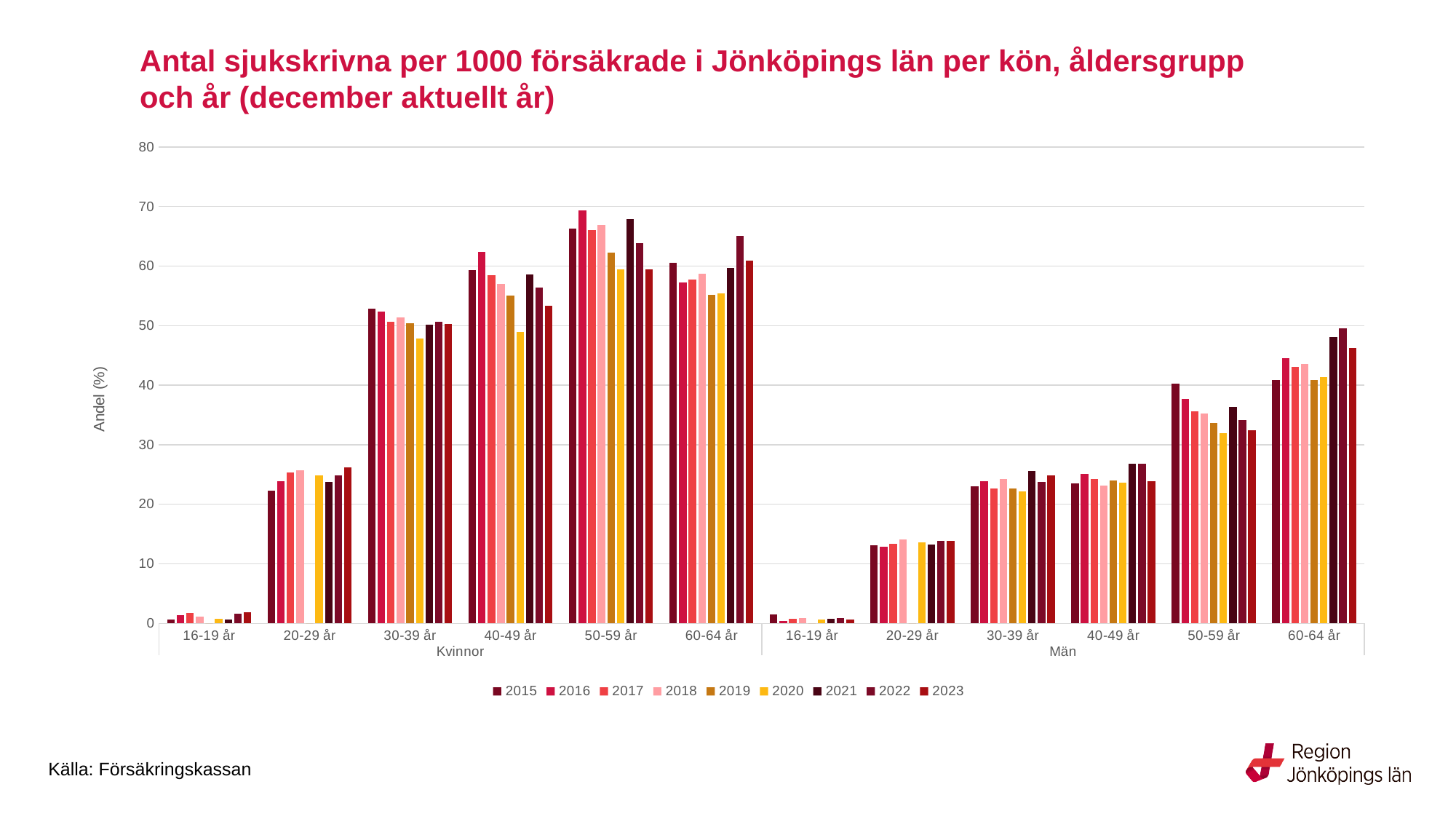
Is the value for Män 30-39 år in 2021 greater or less than 20? greater Is the value for Män 16-19 år in 2015 greater or less than 10? less For Män 50-59 år, do the values rise or fall from 2015 to 2020? fall Which is larger, the value for Kvinnor 50-59 år in 2016 or the value for Män 50-59 år in 2016? Kvinnor 50-59 år in 2016 Is the value for Kvinnor 50-59 år in 2016 greater or less than 60? greater How many age-group categories are shown for Kvinnor? 6 What kind of chart is shown on the slide? bar chart How many series (years) does the legend list? 9 What is the label on the y axis? Andel (%) Which age group has the lowest values for Kvinnor? 16-19 år